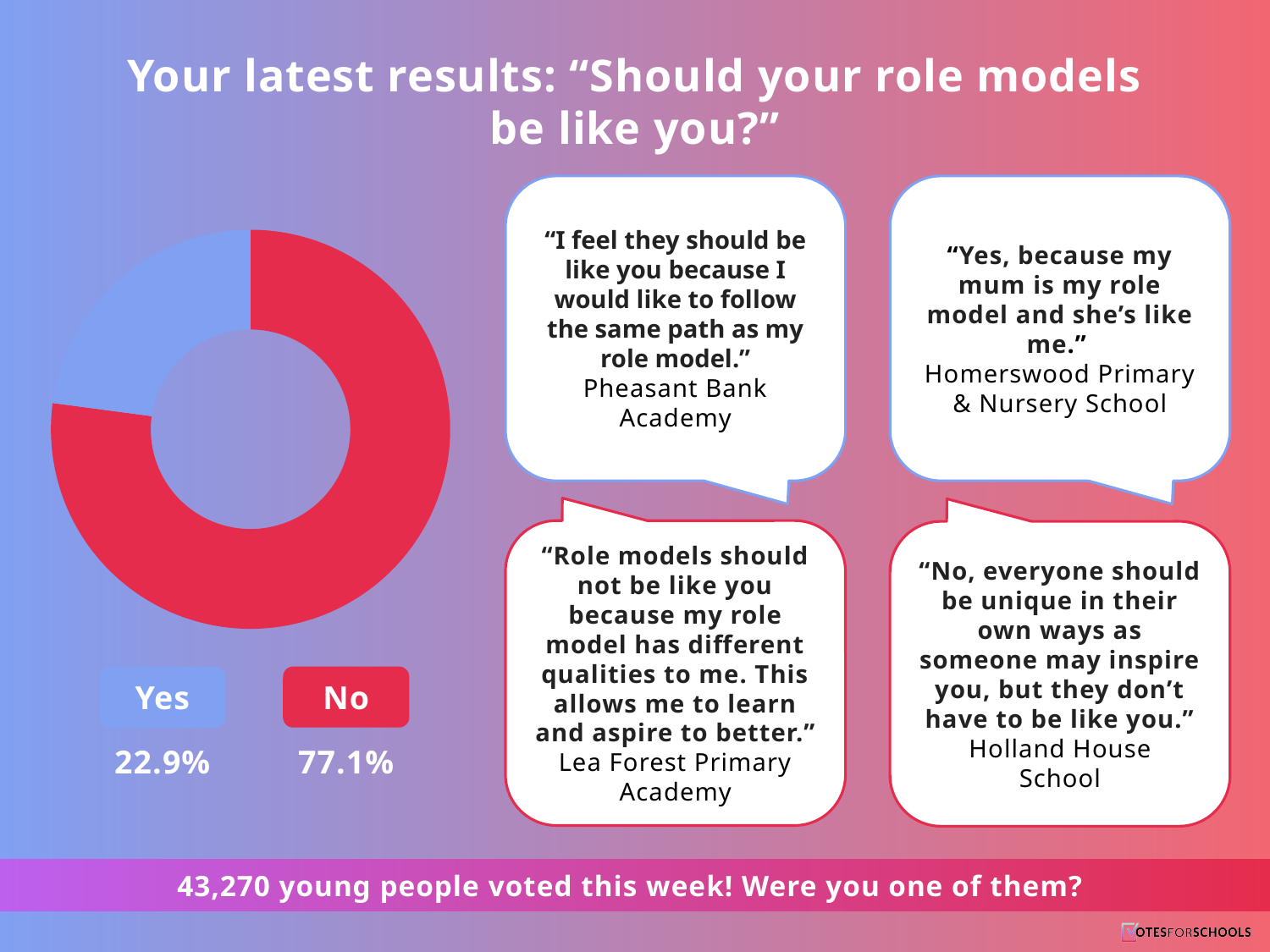
Which response received the largest share of votes? No What kind of chart is shown on the slide? Doughnut (pie) chart What question do the chart results relate to? Should your role models be like you? What colour represents the "Yes" response in the chart? Blue What is the difference in percentage points between the "No" and "Yes" shares? 54.2 What percentage of votes were for "No"? 77.1% How many categories are shown in the chart? 2 Is the share for "No" greater or less than 50%? greater Which is larger, the share for "Yes" or the share for "No"? No What share of the chart does the "No" slice represent? 77.1% What percentage of votes were for "Yes"? 22.9% Which response received the smallest share of votes? Yes